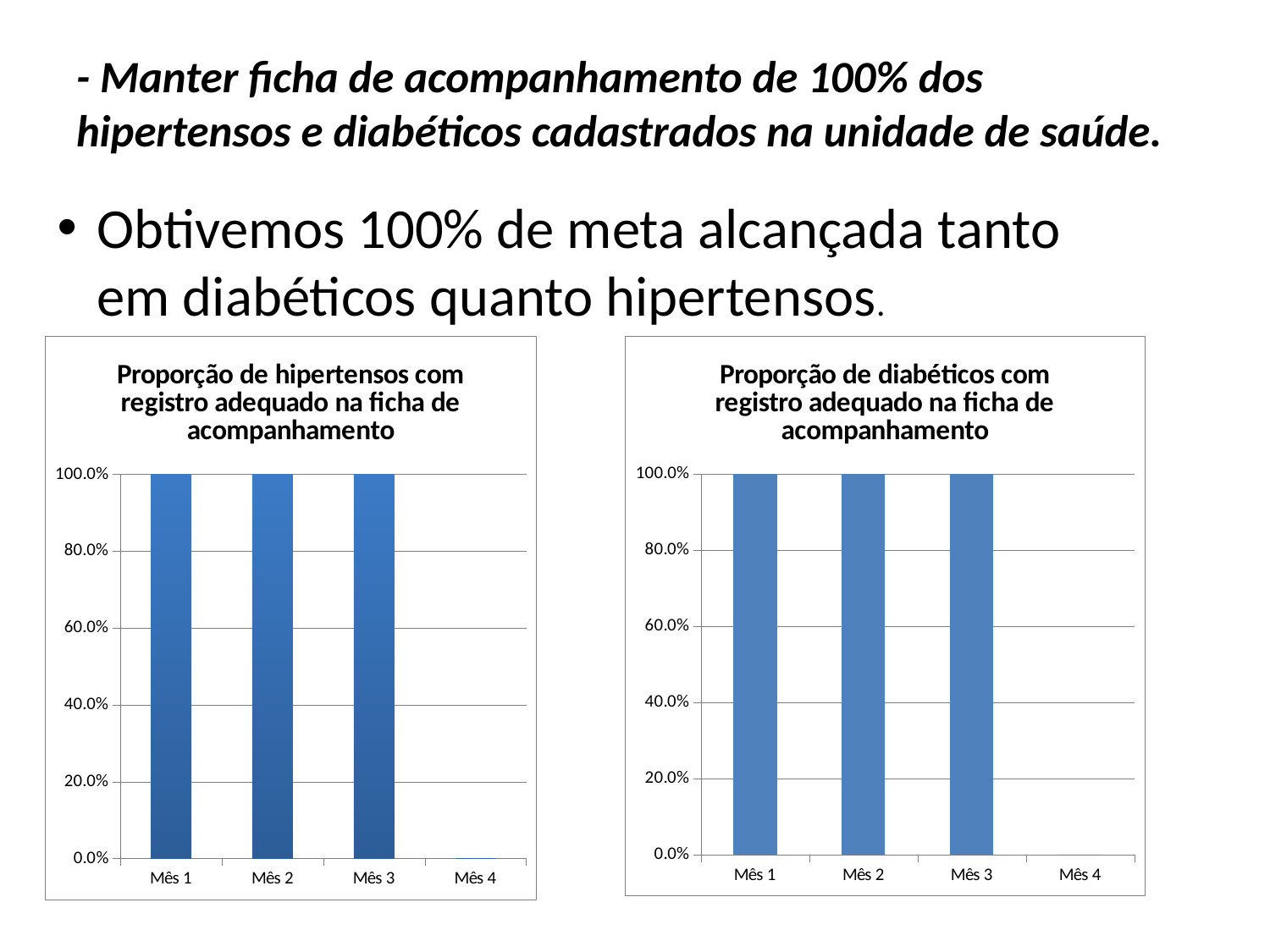
In the chart on the right, is the value for Mês 2 greater or less than 80.0%? greater In the chart on the left, which category has the lowest value? Mês 4 In the chart on the left, what is the difference between the values for Mês 1 and Mês 3? 0.0% What is the title of the chart on the right? Proporção de diabéticos com registro adequado na ficha de acompanhamento What kind of chart is the chart titled 'Proporção de diabéticos com registro adequado na ficha de acompanhamento'? bar chart In the chart titled 'Proporção de hipertensos com registro adequado na ficha de acompanhamento', what is the value for Mês 2? 100.0% In the chart titled 'Proporção de diabéticos com registro adequado na ficha de acompanhamento', what is the value for Mês 3? 100.0% In the chart on the left, which is larger, the value for Mês 3 or the value for Mês 4? Mês 3 How many categories are shown on the x axis of the chart on the right? 4 In the chart on the left, is the value for Mês 4 greater or less than 20.0%? less In the chart on the right, which category has the lowest value? Mês 4 In the chart titled 'Proporção de hipertensos com registro adequado na ficha de acompanhamento', what is the value for Mês 1? 100.0%